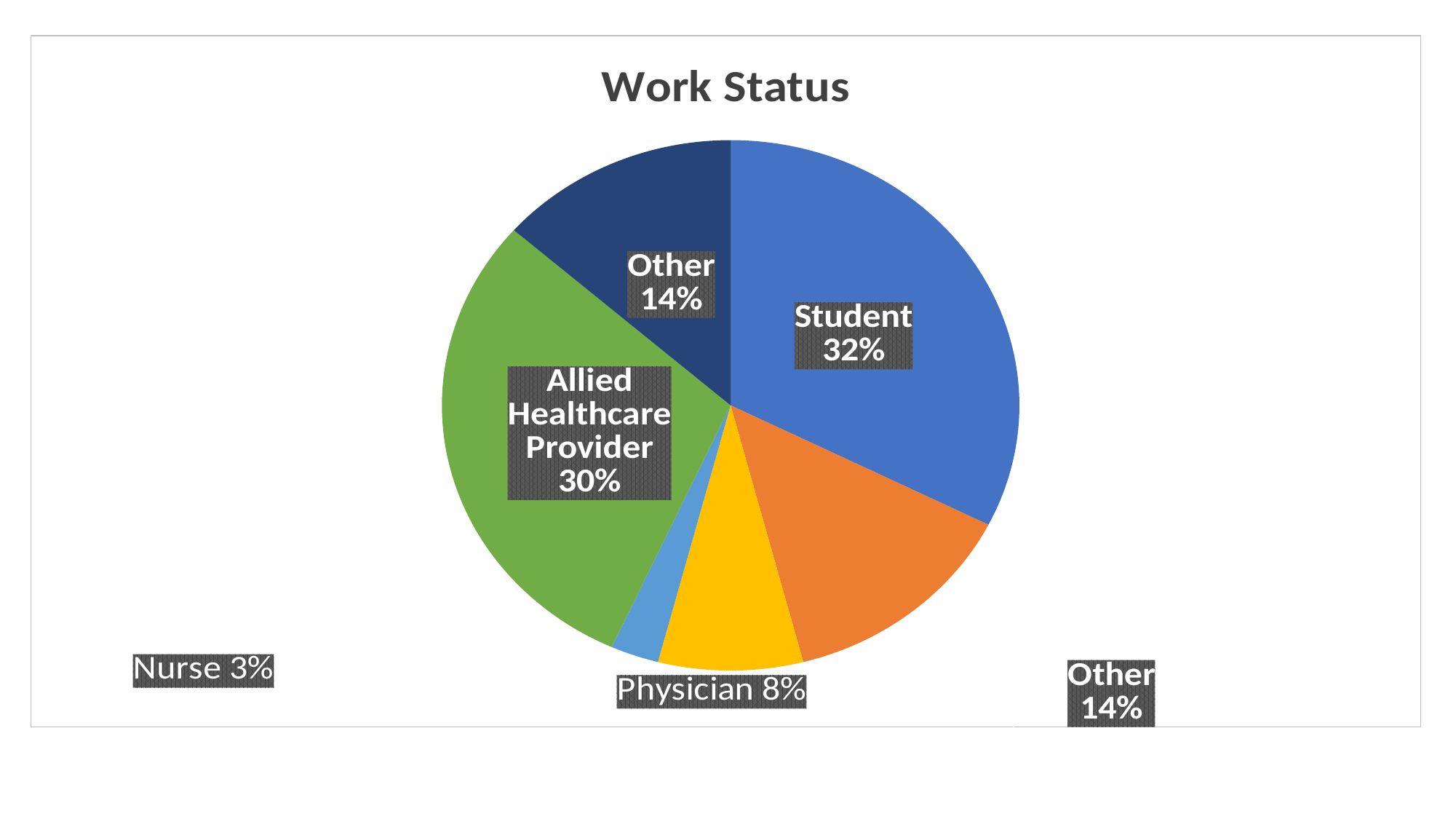
How many slices does the pie chart have? 6 What share of the pie is Nurse? 3% What is the difference in percentage points between Student and Allied Healthcare Provider? 2% What kind of chart is shown on the slide? pie chart What is the difference in percentage points between Allied Healthcare Provider and Physician? 22% What share of the pie is Allied Healthcare Provider? 30% What share of the pie is Student? 32% What is the title of the chart? Work Status Which category has the smallest share of the pie? Nurse Which is larger, the share for Physician or the share for Nurse? Physician What share of the pie is Physician? 8% Which category has the largest share of the pie? Student